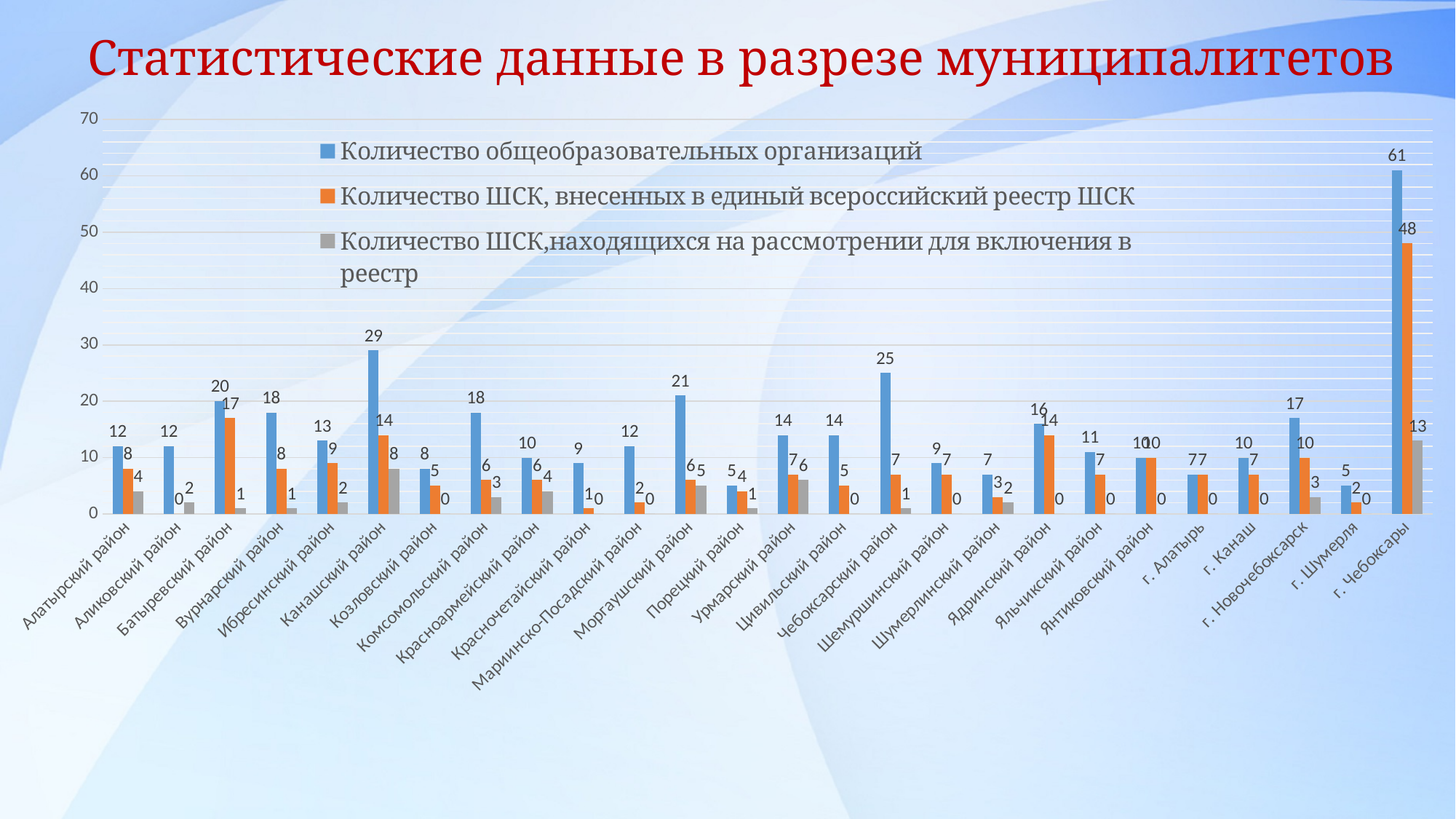
Which is larger for Чебоксарский район: 'Количество общеобразовательных организаций' or 'Количество ШСК, внесенных в единый всероссийский реестр ШСК'? Количество общеобразовательных организаций What is the value of 'Количество ШСК, внесенных в единый всероссийский реестр ШСК' for Батыревский район? 17 Which municipality has the highest value for 'Количество ШСК, внесенных в единый всероссийский реестр ШСК'? г. Чебоксары How many municipalities (categories) are shown on the x axis? 26 What kind of chart is shown on the slide? bar chart What is the title of the chart on the slide? Статистические данные в разрезе муниципалитетов What is the value of 'Количество ШСК, находящихся на рассмотрении для включения в реестр' for г. Чебоксары? 13 Which municipality has the highest value for 'Количество общеобразовательных организаций'? г. Чебоксары What is the value of 'Количество общеобразовательных организаций' for Канашский район? 29 How many series does the legend list? 3 Is the value of 'Количество общеобразовательных организаций' for Моргаушский район greater or less than 20? greater What is the difference between 'Количество общеобразовательных организаций' and 'Количество ШСК, внесенных в единый всероссийский реестр ШСК' for г. Чебоксары? 13